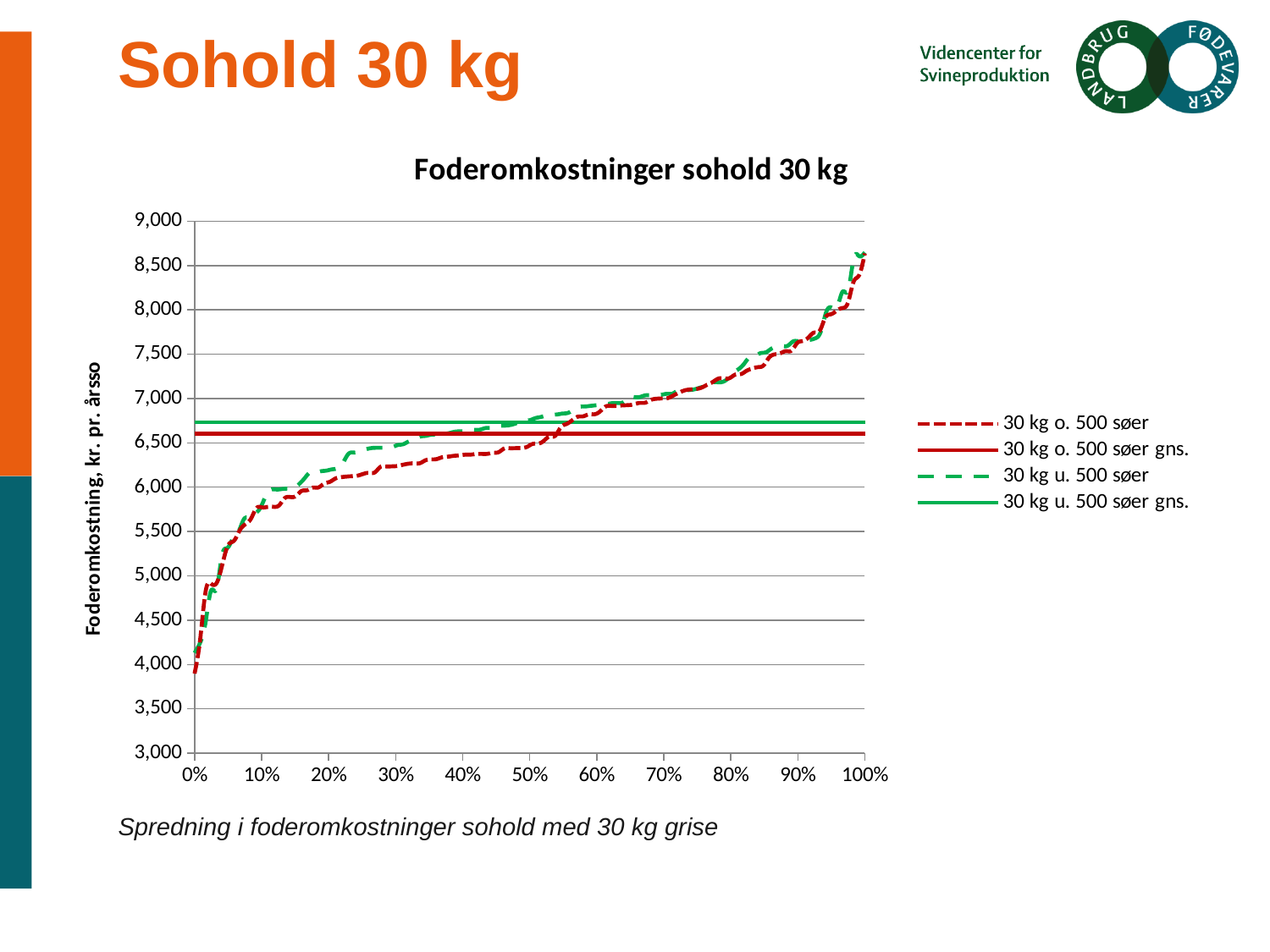
How many series does the legend list? 4 Which average line is higher, '30 kg o. 500 søer gns.' or '30 kg u. 500 søer gns.'? 30 kg u. 500 søer gns. How many tick labels are shown on the x axis of the chart? 11 Is the value of the '30 kg o. 500 søer' series at 80% greater or less than 7,000? greater What kind of chart is shown on the slide? line chart Is the value of the '30 kg u. 500 søer' series at 10% greater or less than 6,000? less Is the value of the '30 kg u. 500 søer' series at 20% greater or less than 6,000? greater What is the title of the chart? Foderomkostninger sohold 30 kg What is the label on the vertical axis of the chart? Foderomkostning, kr. pr. årsso Do the values of the '30 kg o. 500 søer' series rise or fall as the x axis goes from 0% to 100%? rise